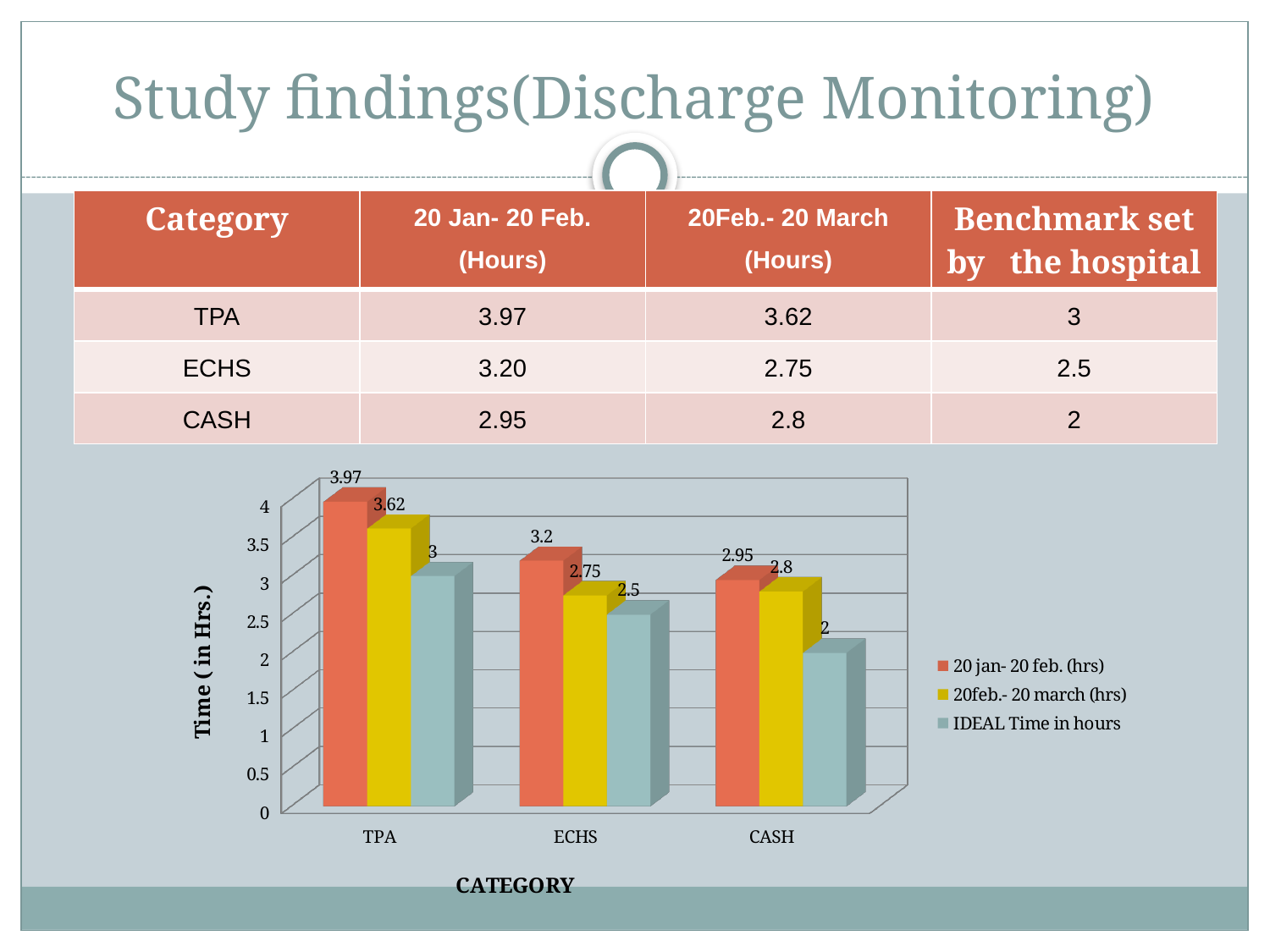
Which is larger for ECHS: the 20 jan- 20 feb. (hrs) value or the 20feb.- 20 march (hrs) value? 20 jan- 20 feb. (hrs) Which category has the lowest IDEAL Time in hours value? CASH What is the difference between the 20 jan- 20 feb. (hrs) value and the 20feb.- 20 march (hrs) value for TPA? 0.35 What is the IDEAL Time in hours value for CASH? 2 What is the label of the chart's y axis? Time ( in Hrs.) How many categories are shown on the x axis of the chart? 3 How many series does the chart legend list? 3 Which category has the highest value in the 20 jan- 20 feb. (hrs) series? TPA What is the value for TPA in the 20 jan- 20 feb. (hrs) series? 3.97 Is the 20feb.- 20 march (hrs) value for CASH greater or less than 2.5? greater What is the value for ECHS in the 20feb.- 20 march (hrs) series? 2.75 What kind of chart is shown on the slide? bar chart